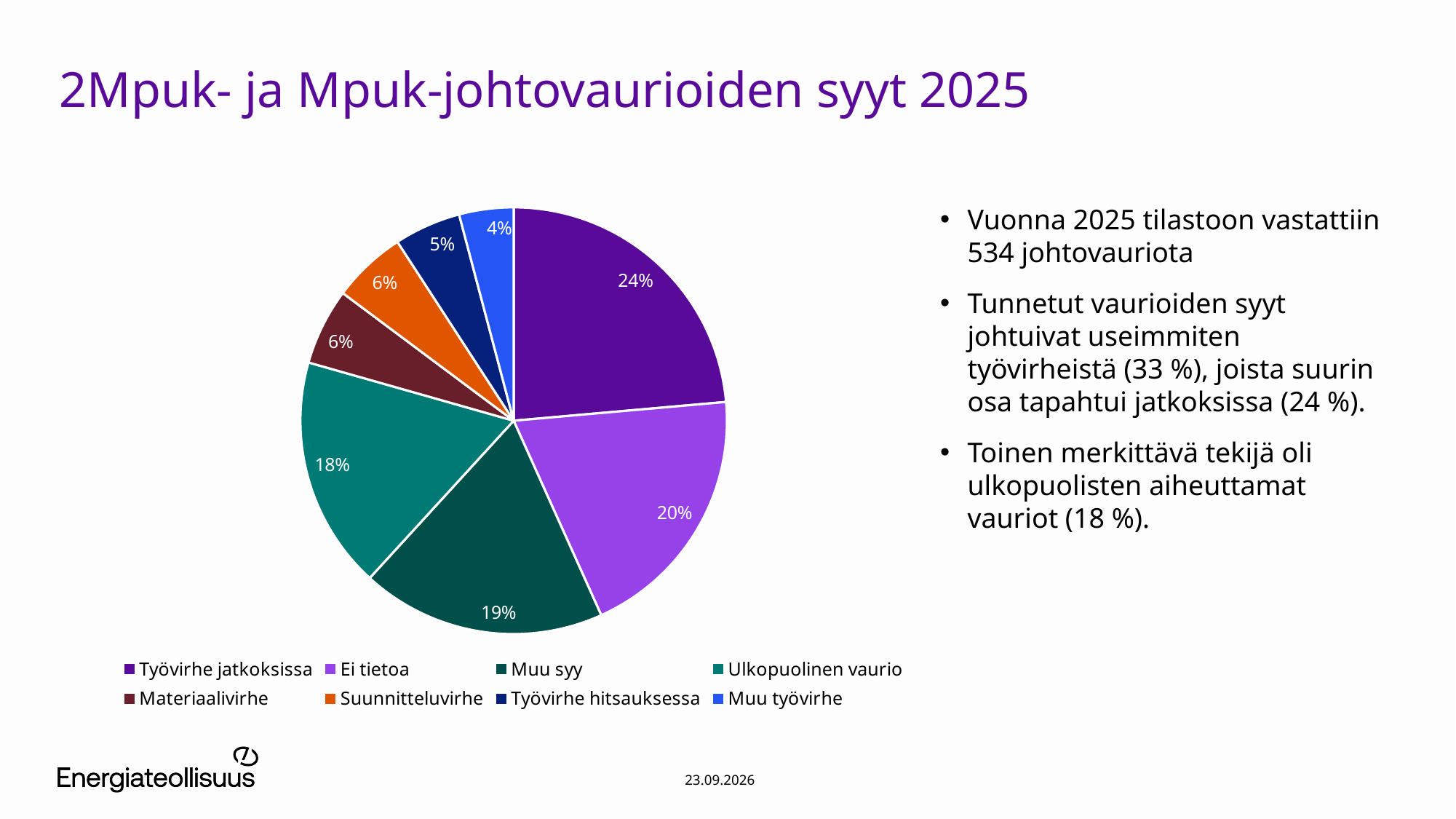
Which category has the smallest slice of the pie? Muu työvirhe What is the value shown for Työvirhe hitsauksessa? 5% Which category has the largest slice of the pie? Työvirhe jatkoksissa What is the difference between the shares of Työvirhe jatkoksissa and Ei tietoa? 4% How many categories does the pie chart have? 8 Which legend entry is shown in orange? Suunnitteluvirhe What is the value shown for Muu syy? 19% Which is larger, the share for Ei tietoa or the share for Ulkopuolinen vaurio? Ei tietoa What share of the pie does Työvirhe jatkoksissa have? 24% What is the title of the slide containing the pie chart? 2Mpuk- ja Mpuk-johtovaurioiden syyt 2025 What type of chart is shown on the slide? pie chart What is the value shown for Ulkopuolinen vaurio? 18%